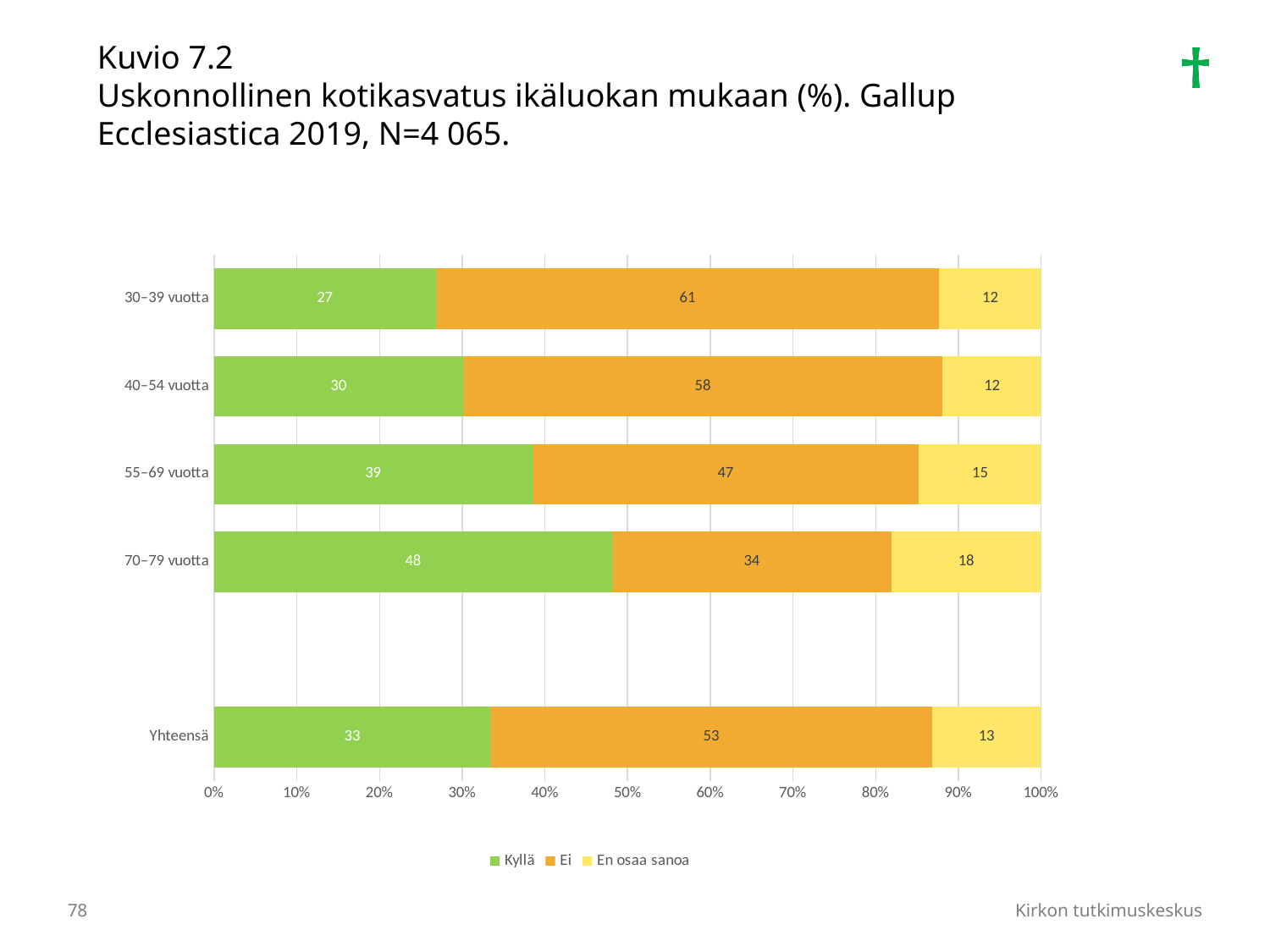
Which is larger, the Kyllä value for 40–54 vuotta or the Kyllä value for 55–69 vuotta? 55–69 vuotta Which series is shown in green in the chart? Kyllä How many categories are shown on the y axis of the chart? 5 How many series does the legend list? 3 Which category has the lowest Ei value? 70–79 vuotta What is the Ei value for the 30–39 vuotta age group? 61 What is the En osaa sanoa value for the 55–69 vuotta age group? 15 What is the difference between the Ei values for 30–39 vuotta and 70–79 vuotta? 27 Which age group has the highest Kyllä value? 70–79 vuotta What is the Kyllä value for the 70–79 vuotta age group? 48 What kind of chart is shown on the slide? Stacked bar chart What is the Ei value for Yhteensä? 53